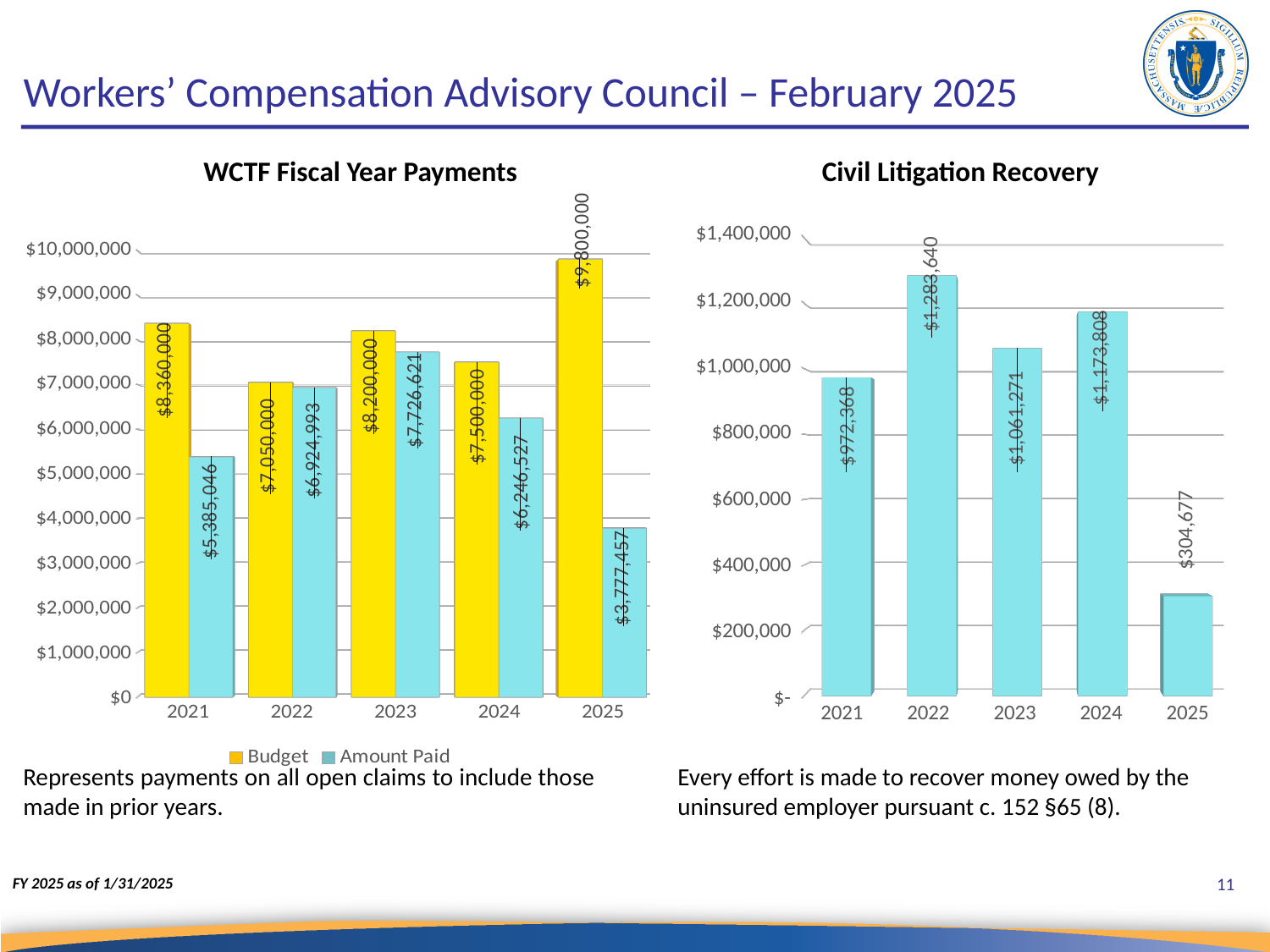
In the WCTF Fiscal Year Payments chart, is the Amount Paid for 2022 larger or smaller than the Amount Paid for 2024? larger How many series does the legend of the WCTF Fiscal Year Payments chart list? 2 In the WCTF Fiscal Year Payments chart, which year has the lowest Amount Paid? 2025 In the Civil Litigation Recovery chart, what is the value for 2024? $1,173,808 How many years are shown on the x axis of the Civil Litigation Recovery chart? 5 In the WCTF Fiscal Year Payments chart, which colour represents the Budget series? yellow In the WCTF Fiscal Year Payments chart, what is the Budget value for 2025? $9,800,000 In the WCTF Fiscal Year Payments chart, what is the Amount Paid for 2023? $7,726,621 In the WCTF Fiscal Year Payments chart, what is the difference between the Budget and the Amount Paid for 2021? $2,974,954 What kind of chart is the Civil Litigation Recovery chart? bar chart In the Civil Litigation Recovery chart, what is the difference between the 2022 and 2023 values? $222,369 In the Civil Litigation Recovery chart, which year has the highest value? 2022